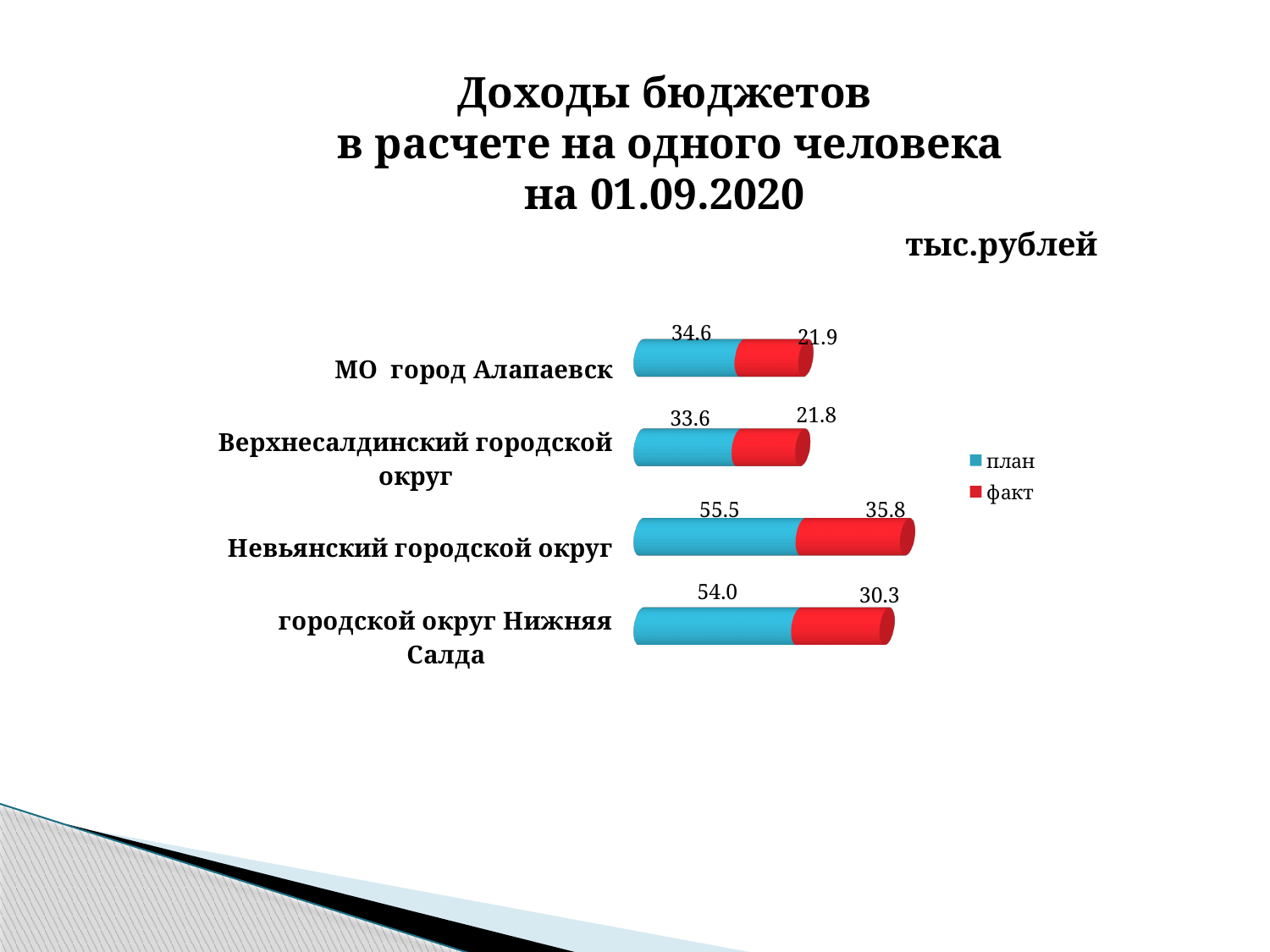
Which category has the highest план value? Невьянский городской округ What is the total of the stacked bar for МО город Алапаевск? 56.5 What is the difference between the план and факт values for Невьянский городской округ? 19.7 What kind of chart is shown on the slide? Bar chart What is the факт value for МО город Алапаевск? 21.9 What is the факт value for Верхнесалдинский городской округ? 21.8 How many categories are shown in the chart? 4 Which is larger: the факт value for городской округ Нижняя Салда or the факт value for Невьянский городской округ? Невьянский городской округ Which category has the lowest факт value? Верхнесалдинский городской округ What is the план value for городской округ Нижняя Салда? 54.0 How many series does the legend list? 2 What is the план value for Невьянский городской округ? 55.5